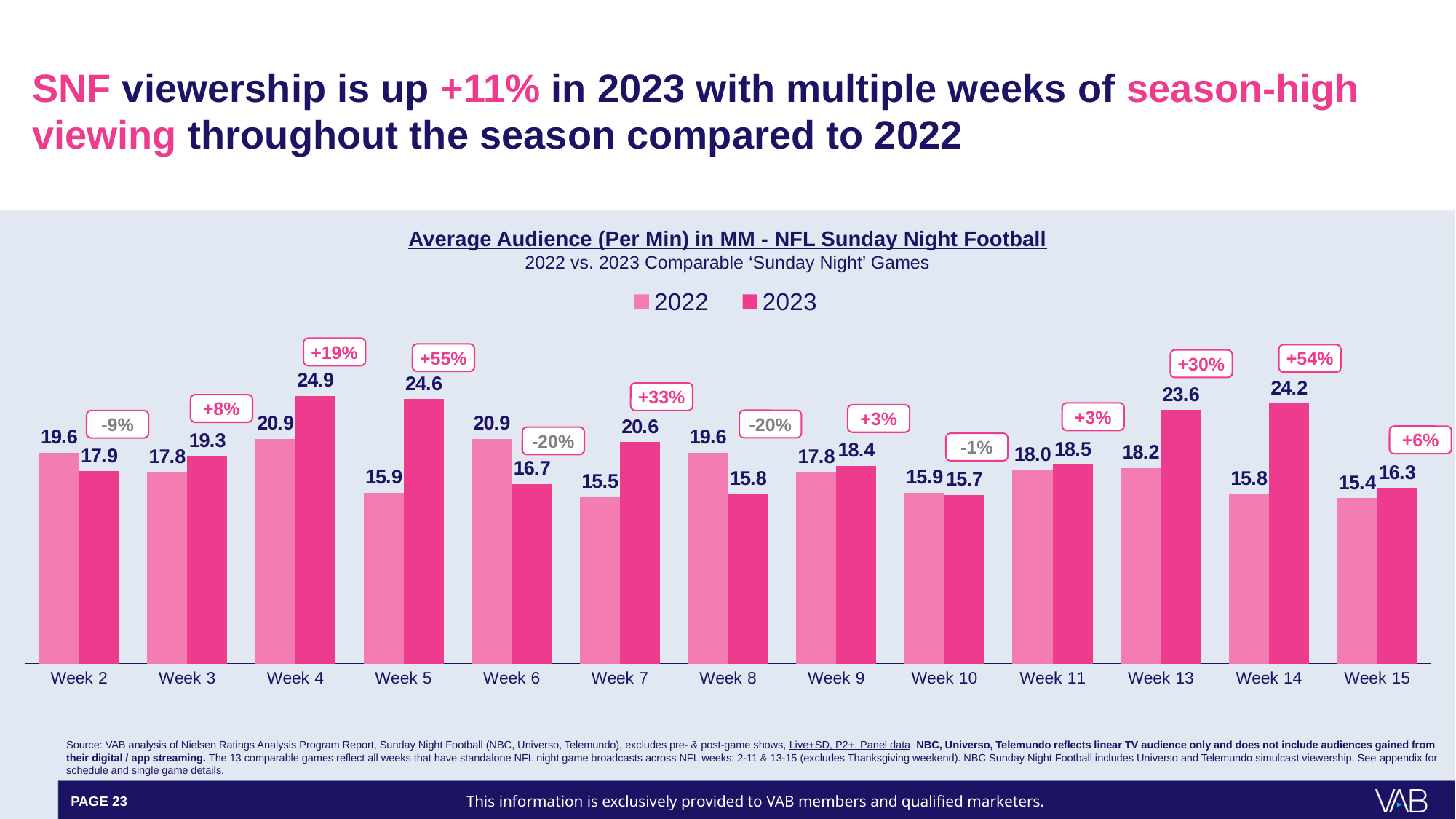
What kind of chart is shown on the slide? Bar chart What is the title of the chart? Average Audience (Per Min) in MM - NFL Sunday Night Football How many series does the legend list? 2 Which week has the highest 2023 average audience? Week 4 What was the 2022 average audience for Week 7? 15.5 What is the difference between the 2023 and 2022 values for Week 5? 8.7 How many weeks are shown on the x axis? 13 What was the 2023 average audience for Week 4? 24.9 What percentage change is shown above the Week 5 bars? +55% What is the difference between the 2023 and 2022 values for Week 14? 8.4 Which week has the lowest 2022 average audience? Week 15 Which is larger for Week 6, the 2022 value or the 2023 value? 2022